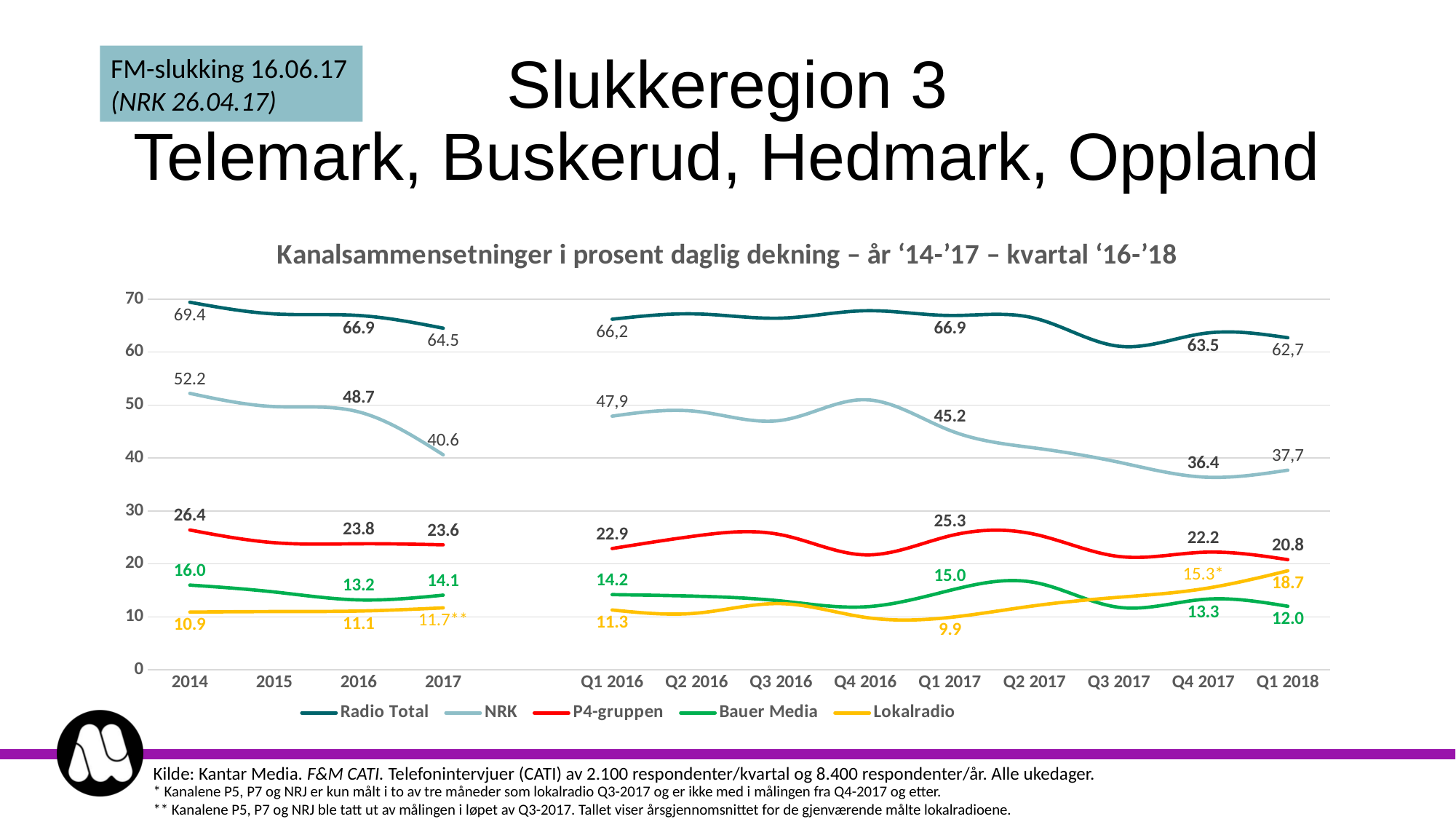
What is the difference between the NRK values in 2014 and 2017? 11.6 What is the value for Lokalradio in Q1 2018? 18.7 What is the value for NRK in 2017? 40.6 Is the value for NRK in Q4 2016 greater or less than 50? greater What is the value for Radio Total in 2014? 69.4 Which is larger: Bauer Media in Q1 2018 or Lokalradio in Q1 2018? Lokalradio Which series has the lowest value in 2014? Lokalradio What is the value for P4-gruppen in Q1 2017? 25.3 What kind of chart is shown on the slide? Line chart Which series has the highest value in Q1 2018? Radio Total What is the value for Bauer Media in Q4 2017? 13.3 How many series does the legend list? 5